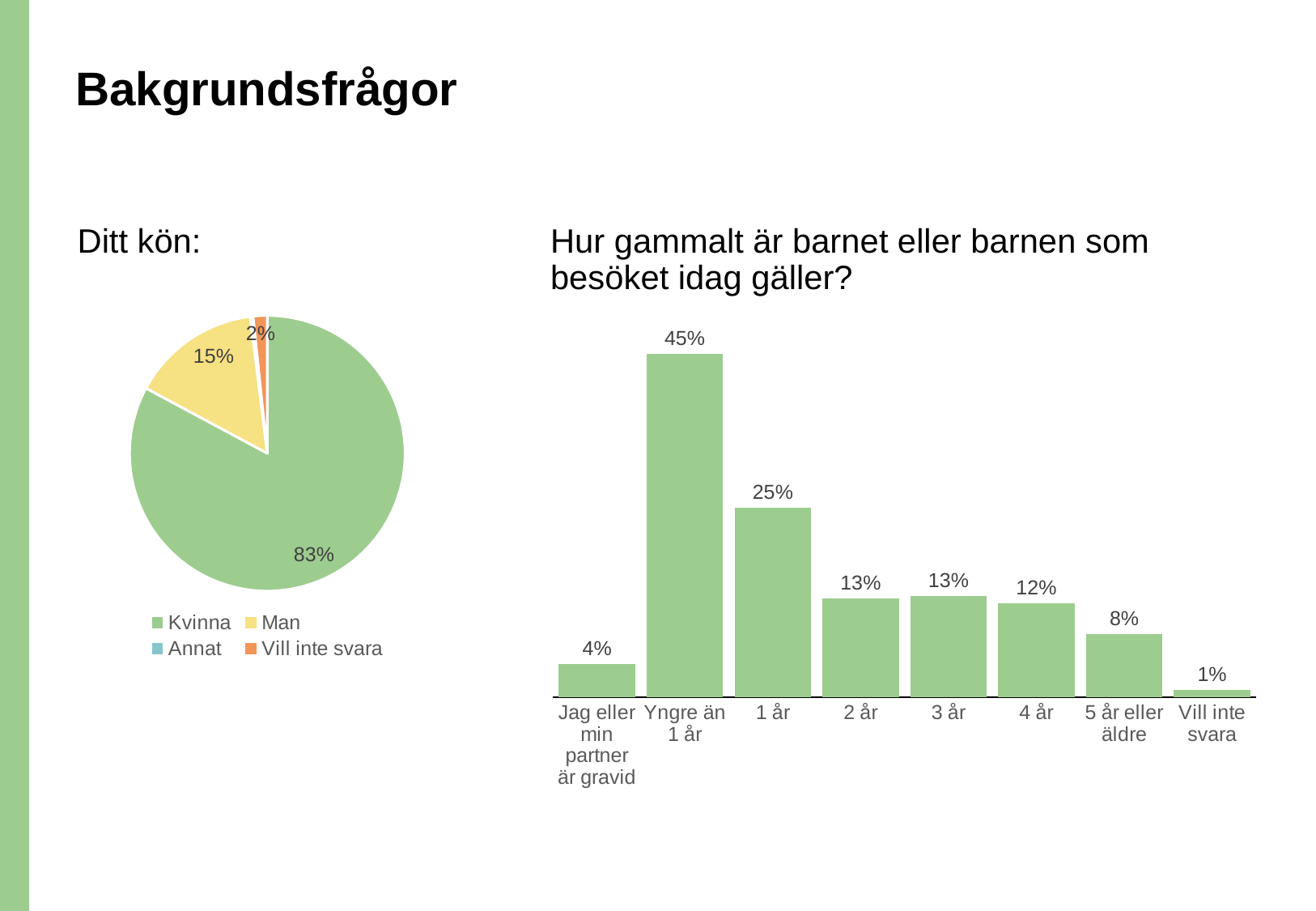
In the bar chart 'Hur gammalt är barnet eller barnen som besöket idag gäller?', which category has the highest value? Yngre än 1 år In the bar chart 'Hur gammalt är barnet eller barnen som besöket idag gäller?', which category has the lowest value? Vill inte svara In the bar chart 'Hur gammalt är barnet eller barnen som besöket idag gäller?', what is the value for 5 år eller äldre? 8% In the bar chart 'Hur gammalt är barnet eller barnen som besöket idag gäller?', how many categories are shown? 8 What kind of chart is the one on the right of the slide? Bar chart In the pie chart 'Ditt kön:', what share is Man? 15% In the pie chart 'Ditt kön:', what share is Vill inte svara? 2% In the pie chart 'Ditt kön:', how many entries does the legend list? 4 In the bar chart 'Hur gammalt är barnet eller barnen som besöket idag gäller?', what is the difference between Yngre än 1 år and 1 år? 20% In the pie chart 'Ditt kön:', what colour is the Man slice? Yellow In the bar chart 'Hur gammalt är barnet eller barnen som besöket idag gäller?', what is the value for Yngre än 1 år? 45% In the pie chart 'Ditt kön:', what share is Kvinna? 83%